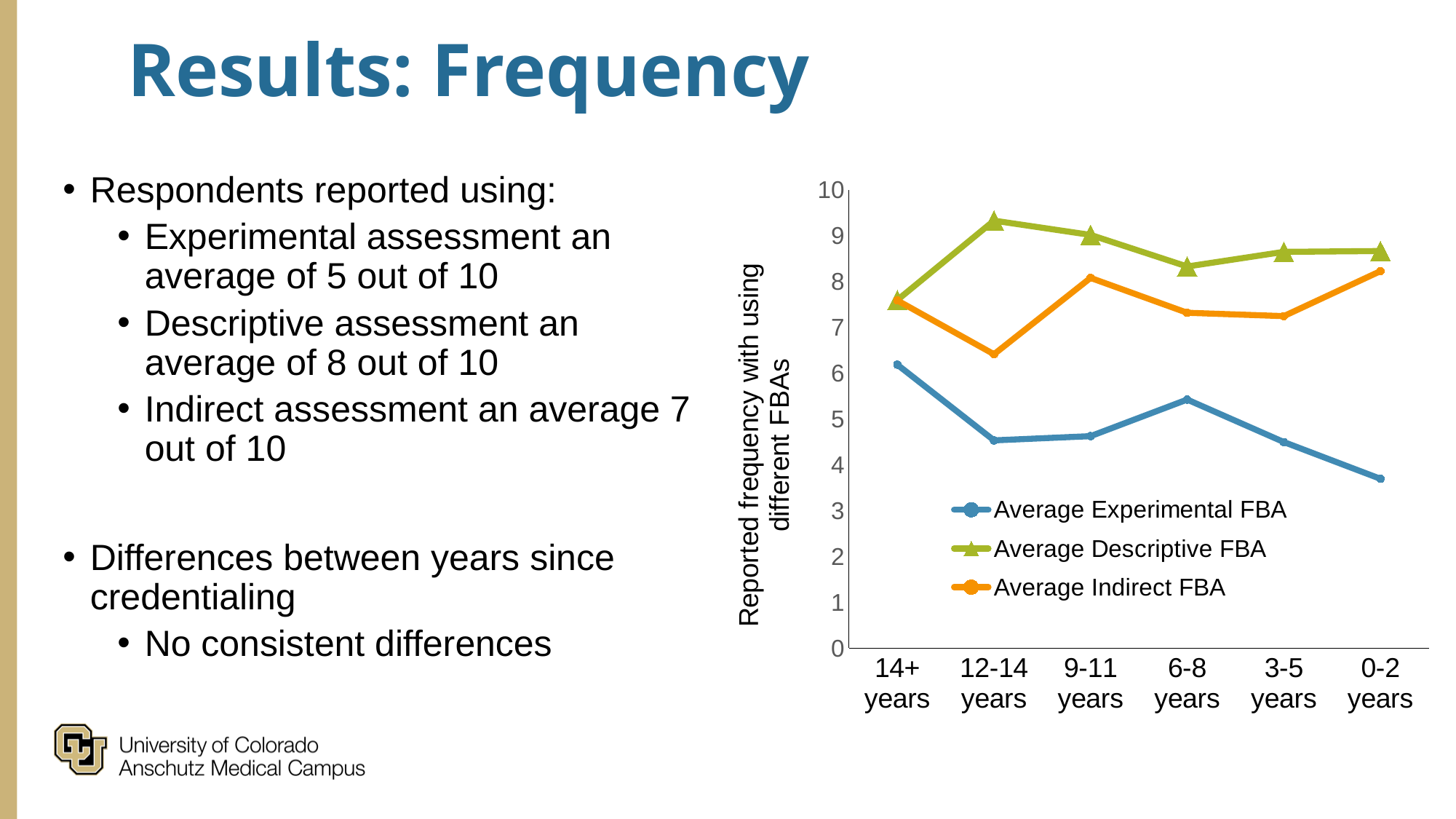
Is the value for Average Descriptive FBA at 12-14 years greater or less than 9? greater Which category has the lowest value for Average Indirect FBA? 12-14 years What kind of chart is shown on the slide? line chart How many year-since-credentialing categories are shown on the x axis? 6 How many series does the legend list? 3 Is the value for Average Experimental FBA at 14+ years greater or less than 5? greater At 9-11 years, which is larger: Average Descriptive FBA or Average Indirect FBA? Average Descriptive FBA Is the value for Average Experimental FBA at 0-2 years greater or less than 4? less What is the title of the y axis? Reported frequency with using different FBAs Which category has the lowest value for Average Experimental FBA? 0-2 years Which category has the highest value for Average Descriptive FBA? 12-14 years